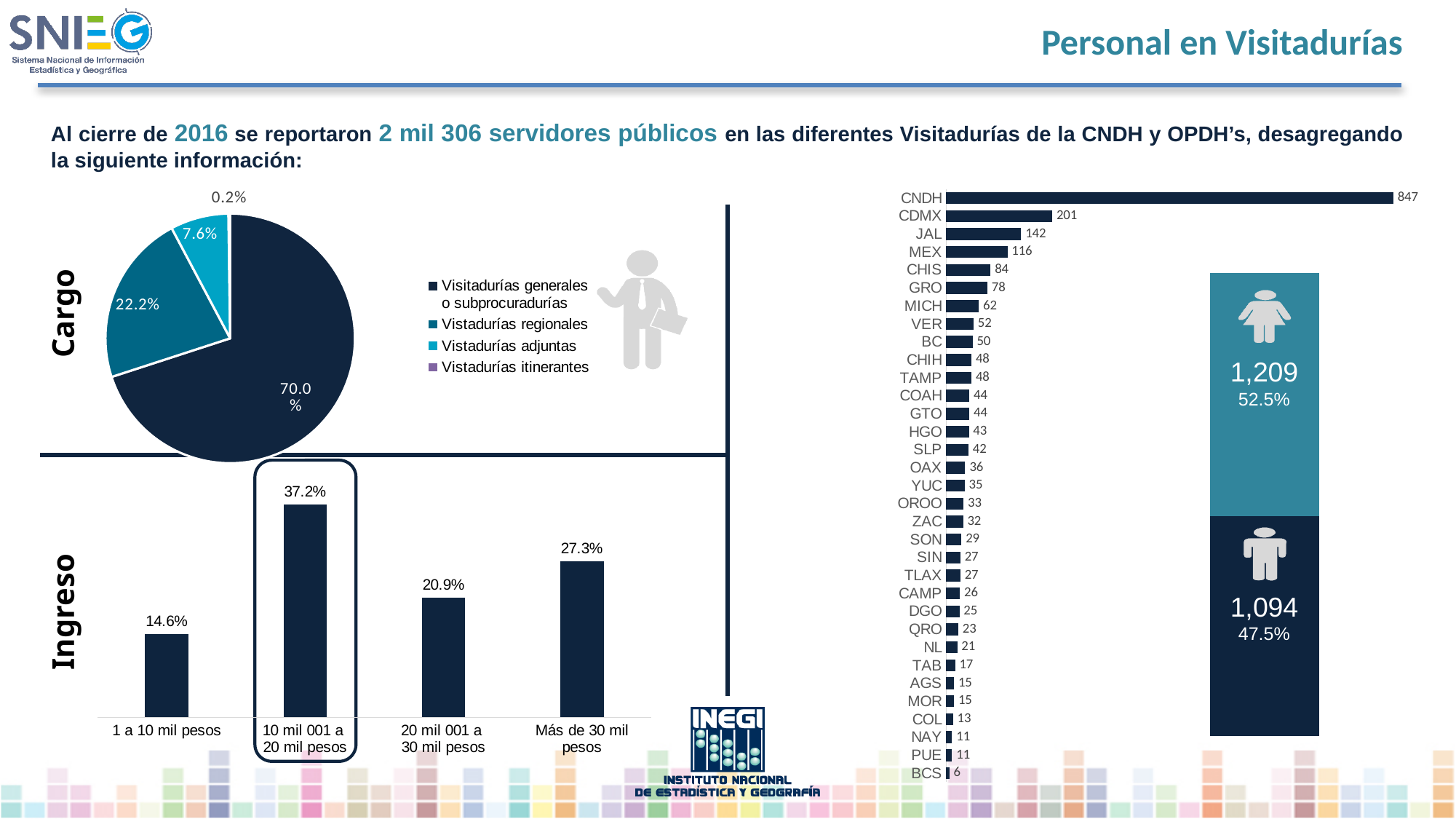
In the bar chart by state on the right, how many categories are shown? 33 How many entries does the legend of the Cargo pie chart list? 4 In the Ingreso bar chart, which income category has the lowest value? 1 a 10 mil pesos In the Cargo pie chart, what share is Vistadurías regionales? 22.2% What kind of chart is the Ingreso chart? bar chart In the Cargo pie chart, what share is Visitadurías generales o subprocuradurías? 70.0% In the Cargo pie chart, which category has the smallest slice? Vistadurías itinerantes In the Ingreso bar chart, what is the difference between Más de 30 mil pesos and 20 mil 001 a 30 mil pesos? 6.4% In the Ingreso bar chart, what is the value for 10 mil 001 a 20 mil pesos? 37.2% In the bar chart by state on the right, what is the difference between CDMX and MEX? 85 In the bar chart by state on the right, what is the value for JAL? 142 In the bar chart by state on the right, which category has the highest value? CNDH